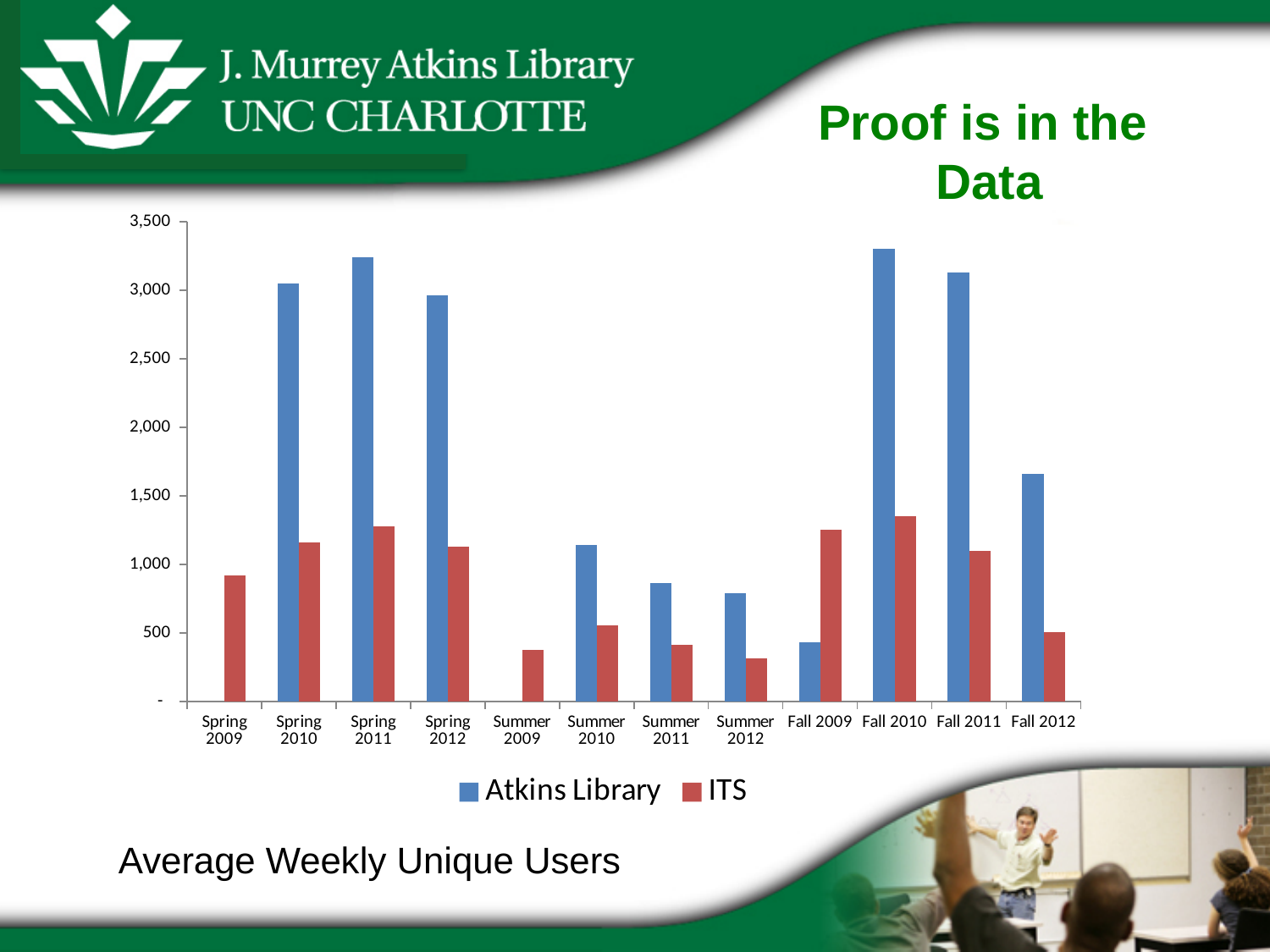
Is the ITS value for Summer 2009 greater or less than 500? less In Spring 2011, which series has the larger value, Atkins Library or ITS? Atkins Library In Fall 2009, which series has the larger value, Atkins Library or ITS? ITS How many series does the legend list? 2 Do the Atkins Library values rise or fall from Summer 2010 to Summer 2012? fall Which series is shown in red in the legend? ITS What caption appears below the chart? Average Weekly Unique Users Is the ITS value for Fall 2009 greater or less than 1,000? greater Is the Atkins Library value for Fall 2012 greater or less than 1,500? greater How many semester categories are shown on the x axis? 12 What kind of chart is shown on the slide? bar chart